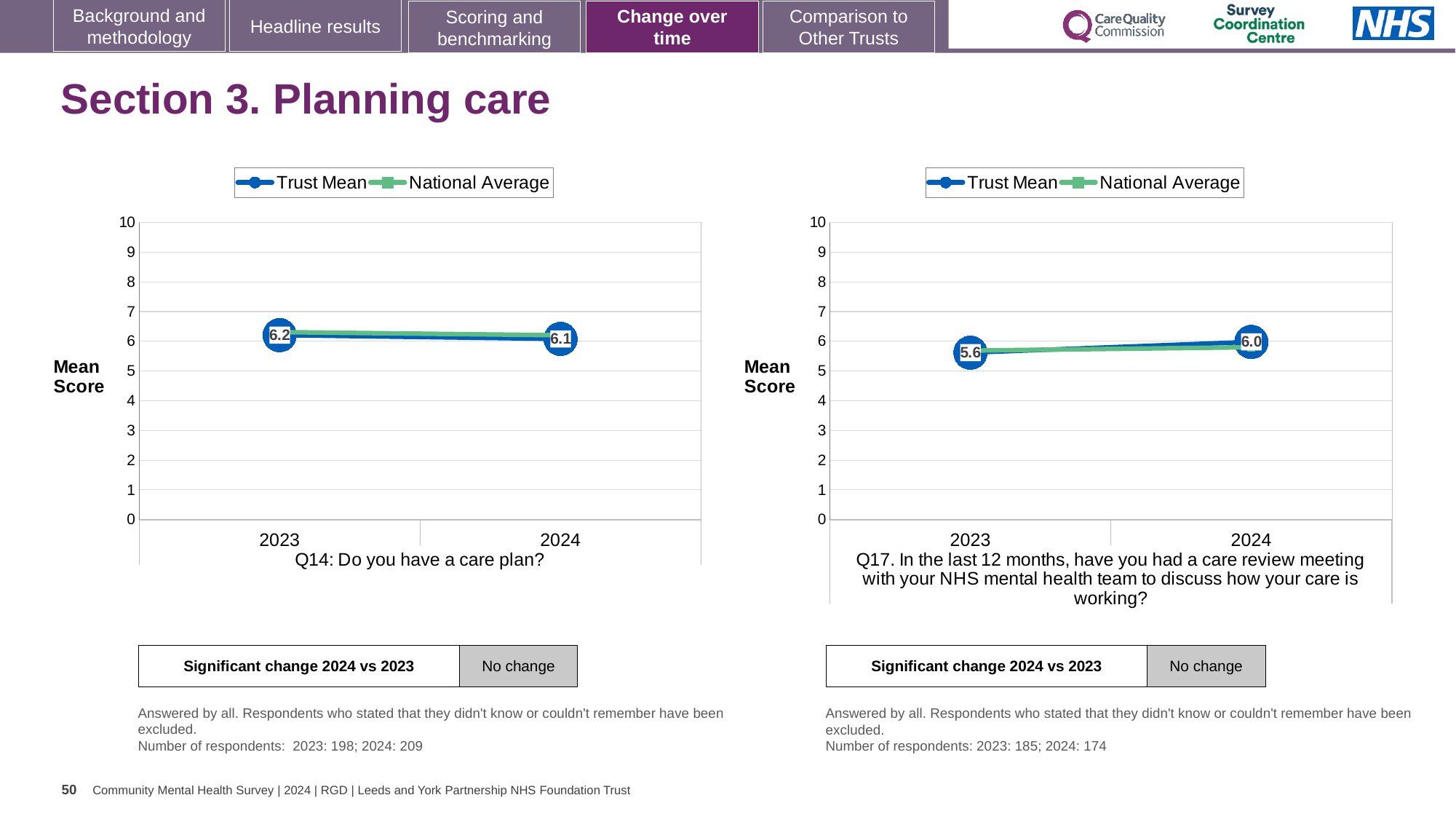
In the right chart (Q17, care review meeting), what is the Trust Mean for 2024? 6.0 In the right chart (Q17, care review meeting), does the Trust Mean rise or fall from 2023 to 2024? rise In the left chart (Q14: Do you have a care plan?), what is the Trust Mean for 2023? 6.2 In the right chart (Q17, care review meeting), is the National Average for 2023 greater or less than 5? greater What kind of chart is the left chart (Q14: Do you have a care plan?)? line chart In the right chart (Q17, care review meeting), what is the Trust Mean for 2023? 5.6 In the right chart (Q17, care review meeting), by how much did the Trust Mean change from 2023 to 2024? 0.4 How many series does the legend of the left chart (Q14: Do you have a care plan?) list? 2 In the left chart (Q14: Do you have a care plan?), does the Trust Mean rise or fall from 2023 to 2024? fall How many years are plotted on the x axis of the right chart (Q17, care review meeting)? 2 In the left chart (Q14: Do you have a care plan?), which year has the higher Trust Mean, 2023 or 2024? 2023 In the left chart (Q14: Do you have a care plan?), what is the Trust Mean for 2024? 6.1